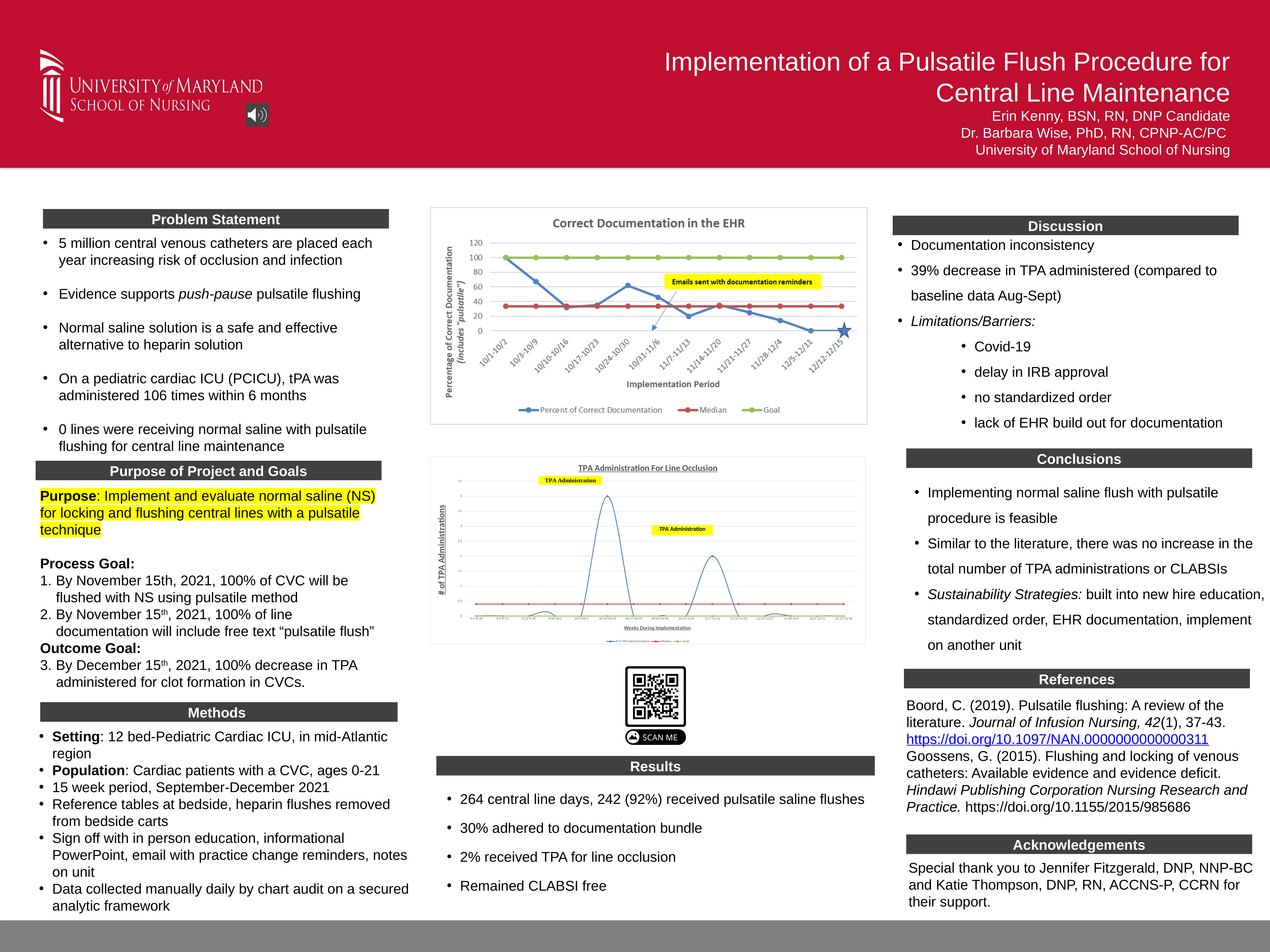
In the 'Correct Documentation in the EHR' chart, what does the yellow annotation box say? Emails sent with documentation reminders In the 'Correct Documentation in the EHR' chart, is the Percent of Correct Documentation for 11/7-11/13 greater or less than 40? less What kind of chart is the 'Correct Documentation in the EHR' chart? line chart In the 'Correct Documentation in the EHR' chart, how many series does the legend list? 3 In the 'Correct Documentation in the EHR' chart, what is the Percent of Correct Documentation for 12/5-12/11? 0 In the 'Correct Documentation in the EHR' chart, is the Percent of Correct Documentation for 10/3-10/9 greater or less than 60? greater In the 'Correct Documentation in the EHR' chart, what is the Percent of Correct Documentation for 10/1-10/2? 100 In the 'TPA Administration For Line Occlusion' chart, what is the number of TPA administrations at the peak in week 10/10-10/16? 4 In the 'TPA Administration For Line Occlusion' chart, which week has the highest number of TPA administrations? 10/10-10/16 In the 'Correct Documentation in the EHR' chart, does the Percent of Correct Documentation generally rise or fall across the implementation period? fall In the 'Correct Documentation in the EHR' chart, what value does the Goal line sit at? 100 In the 'Correct Documentation in the EHR' chart, how many implementation periods are shown on the x axis? 12